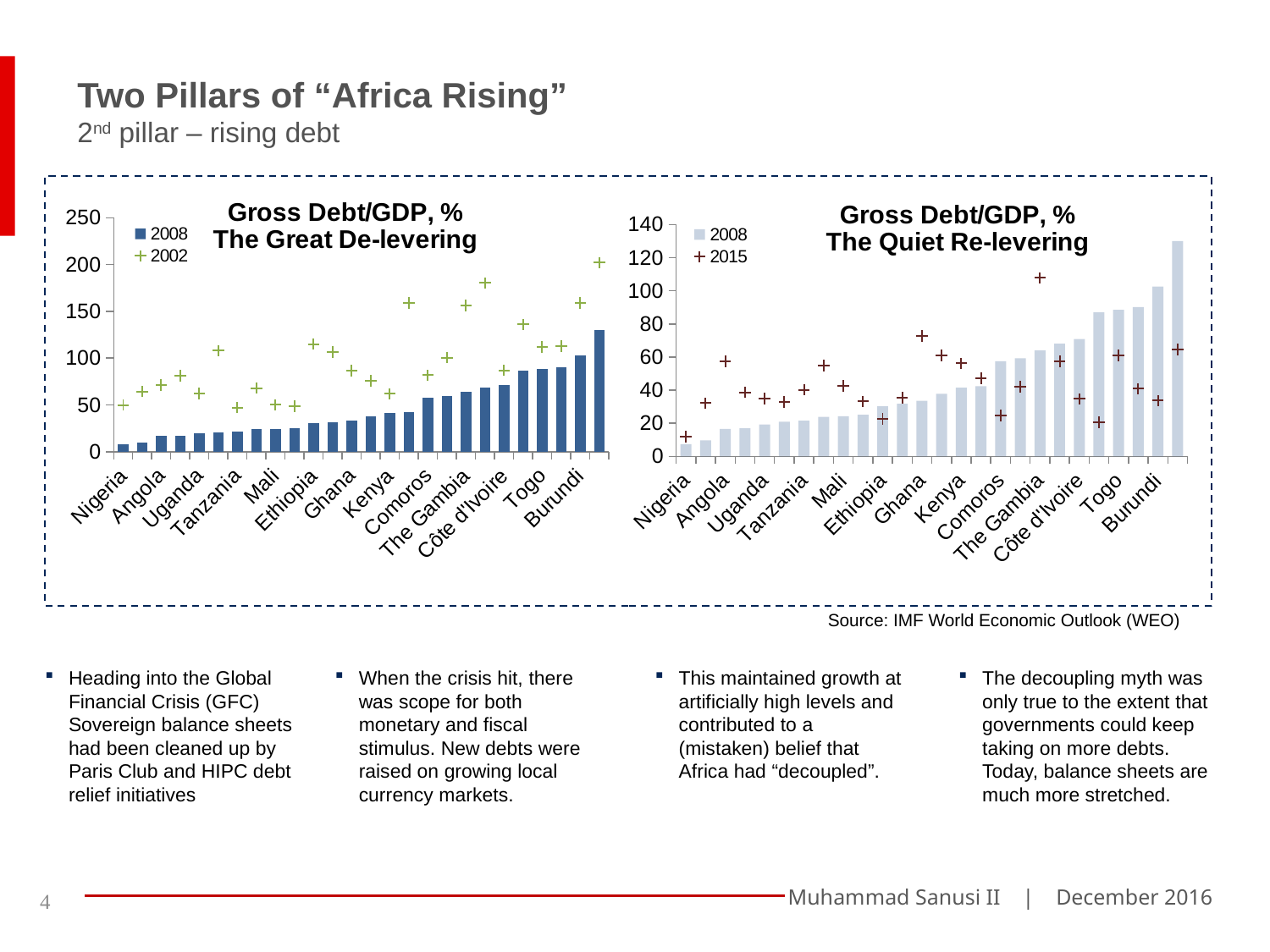
What kind of chart is the chart titled "The Quiet Re-levering"? bar chart In the chart titled "The Great De-levering", how many series does the legend list? 2 In the chart titled "The Great De-levering", is the 2008 value for Nigeria greater or less than 50? less In the chart titled "The Quiet Re-levering", which two series does the legend list? 2008 and 2015 In the chart titled "The Quiet Re-levering", which is larger, the 2008 bar for Togo or the 2008 bar for Nigeria? Togo In the chart titled "The Great De-levering", which category has the lowest 2008 bar? Nigeria In the chart titled "The Great De-levering", do the 2008 bars rise or fall from left to right along the x axis? rise In the chart titled "The Quiet Re-levering", is the 2008 value for Nigeria greater or less than 20? less